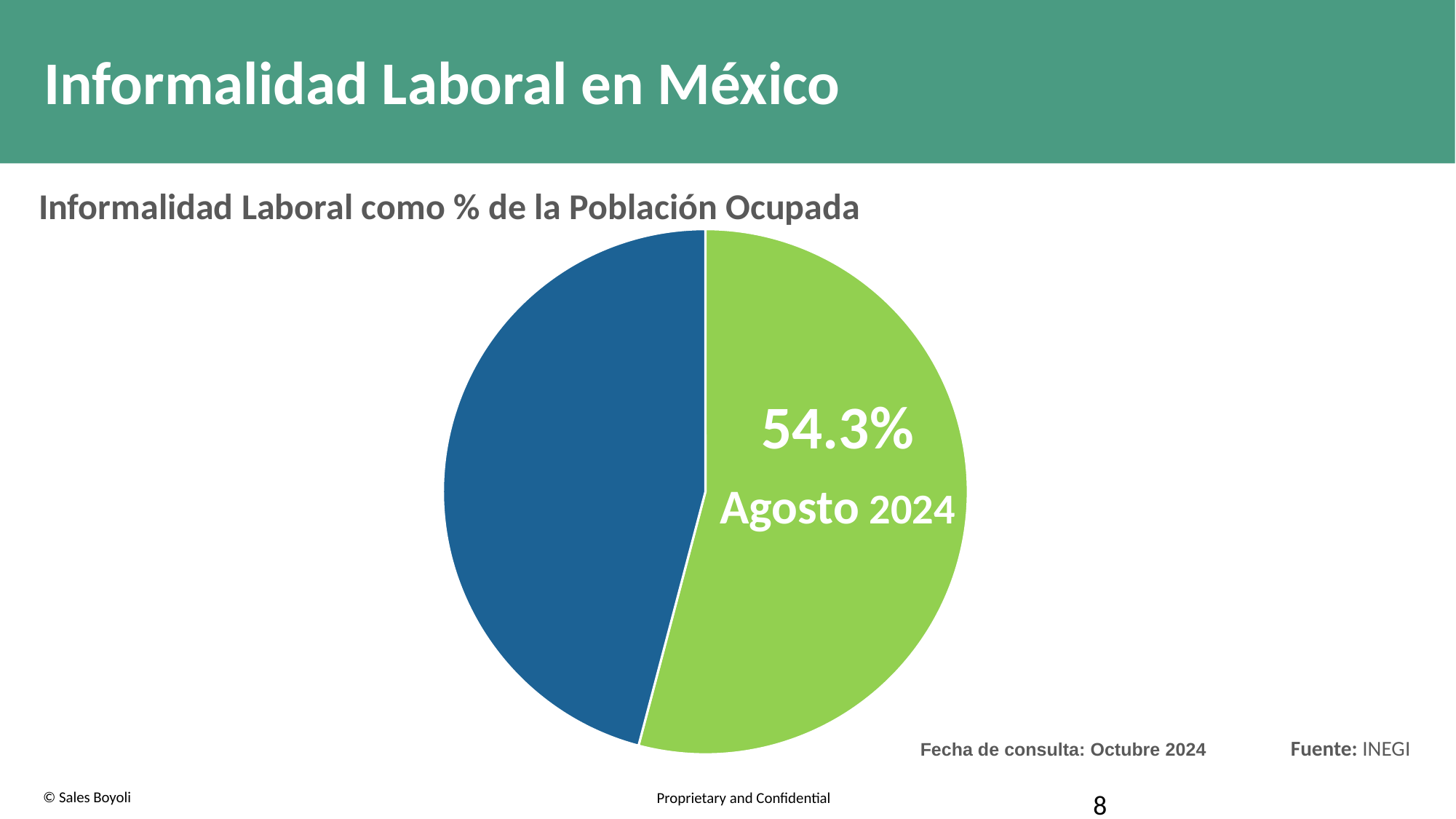
Is the share of the blue slice greater or less than 50%? less What kind of chart is shown on the slide? pie chart Which slice of the pie chart is the largest? the green slice (54.3%) What share of the pie does the green slice labelled Agosto 2024 represent? 54.3% What period is labelled on the green slice of the pie chart? Agosto 2024 Is the share of the green slice greater or less than 50%? greater What value is printed on the green slice of the pie chart? 54.3% How many slices does the pie chart have? 2 What is the title of the chart? Informalidad Laboral como % de la Población Ocupada Which slice of the pie chart is the smallest? the blue slice Which slice is larger, the green slice or the blue slice? the green slice